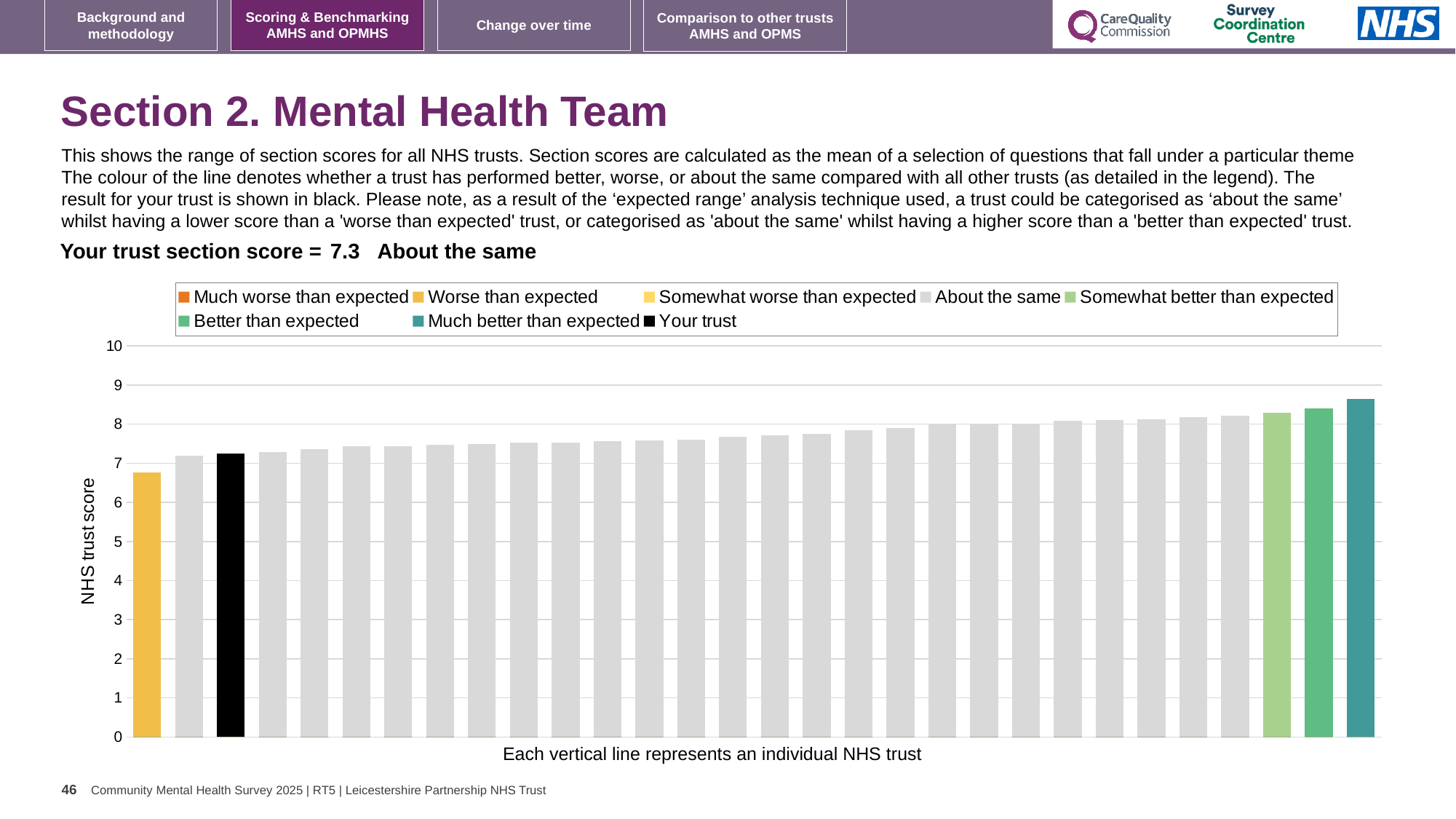
Which category is your trust placed in for this section? About the same Is the value of the rightmost (teal) bar greater or less than 8? greater What is the label on the vertical axis of the chart? NHS trust score Which is larger, the leftmost yellow bar or the black 'Your trust' bar? the black 'Your trust' bar What kind of chart is shown on the slide? bar chart Which legend category does the lowest bar belong to? Worse than expected Which legend category does the highest bar belong to? Much better than expected How many entries does the chart legend list? 8 Do the bar values rise or fall moving from left to right along the x axis? rise Is the value of the leftmost (yellow) bar greater or less than 7? less Is the value of the black 'Your trust' bar greater or less than 7? greater What is the section score for your trust shown on the slide? 7.3